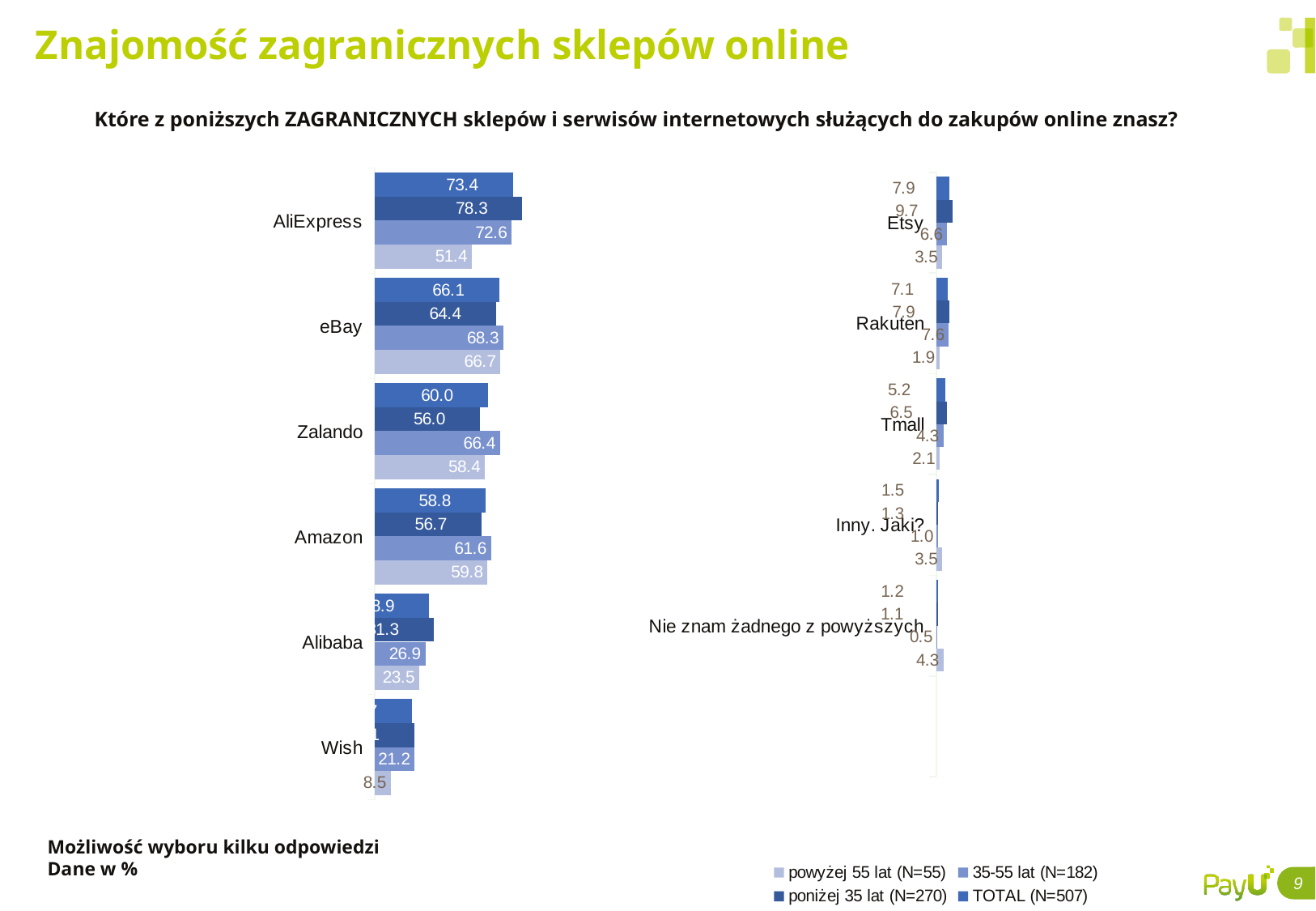
In the right chart, which is larger for Rakuten: the value for poniżej 35 lat (N=270) or for powyżej 55 lat (N=55)? poniżej 35 lat (N=270) In the left chart, what is the difference between the AliExpress values for poniżej 35 lat (N=270) and powyżej 55 lat (N=55)? 26.9 In the right chart, what is the value for 'Nie znam żadnego z powyższych' among respondents powyżej 55 lat (N=55)? 4.3 In the left chart, what is the value for Zalando among respondents poniżej 35 lat (N=270)? 56.0 In the left chart, what is the TOTAL (N=507) value for AliExpress? 73.4 In the right chart, what is the value for Etsy among respondents poniżej 35 lat (N=270)? 9.7 How many stores or categories are shown in the left chart? 6 In the left chart, what is the value for Amazon among respondents powyżej 55 lat (N=55)? 59.8 In the left chart, what is the value for eBay among respondents aged 35-55 lat (N=182)? 68.3 How many series does the legend list? 4 In the right chart, which category has the lowest value among respondents aged 35-55 lat (N=182)? Nie znam żadnego z powyższych In the left chart, which store has the highest TOTAL (N=507) value? AliExpress